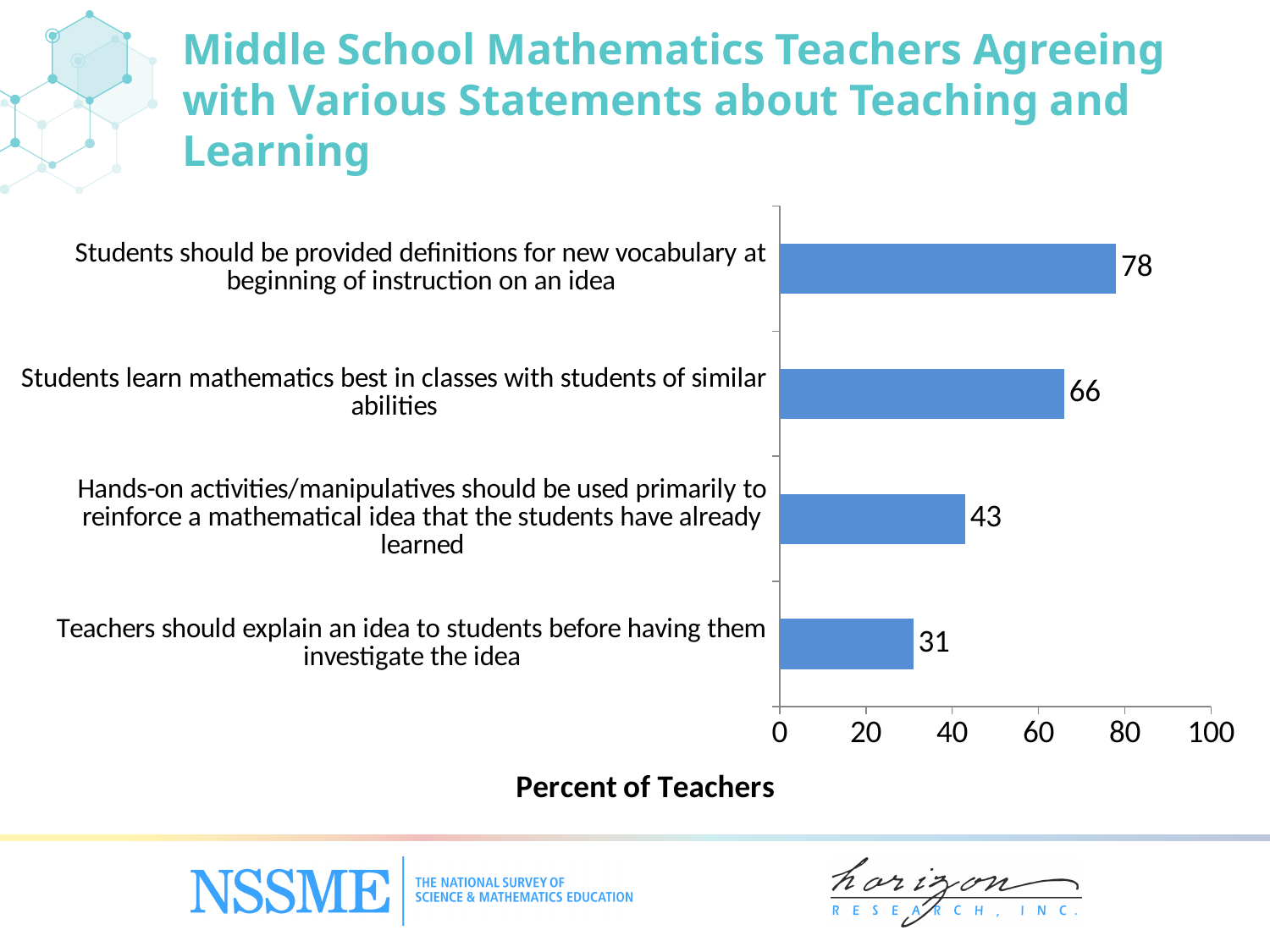
What percent of teachers agree that students learn mathematics best in classes with students of similar abilities? 66 What percent of teachers agree that teachers should explain an idea to students before having them investigate the idea? 31 What percent of teachers agree that students should be provided definitions for new vocabulary at the beginning of instruction on an idea? 78 How many statements are shown in the chart? 4 What percent of teachers agree that hands-on activities/manipulatives should be used primarily to reinforce a mathematical idea that the students have already learned? 43 Which statement has the highest percent of teachers agreeing? Students should be provided definitions for new vocabulary at beginning of instruction on an idea Which has a higher percent of teachers agreeing: the statement about students learning best in classes with similar abilities, or the statement about hands-on activities reinforcing already-learned ideas? Students learn mathematics best in classes with students of similar abilities What is the label on the horizontal axis of the chart? Percent of Teachers Which statement has the lowest percent of teachers agreeing? Teachers should explain an idea to students before having them investigate the idea What kind of chart is shown on the slide? Bar chart What is the difference in percent of teachers between the statement about providing definitions for new vocabulary and the statement about explaining an idea before students investigate it? 47 Is the value for the statement about hands-on activities/manipulatives greater or less than 40? greater